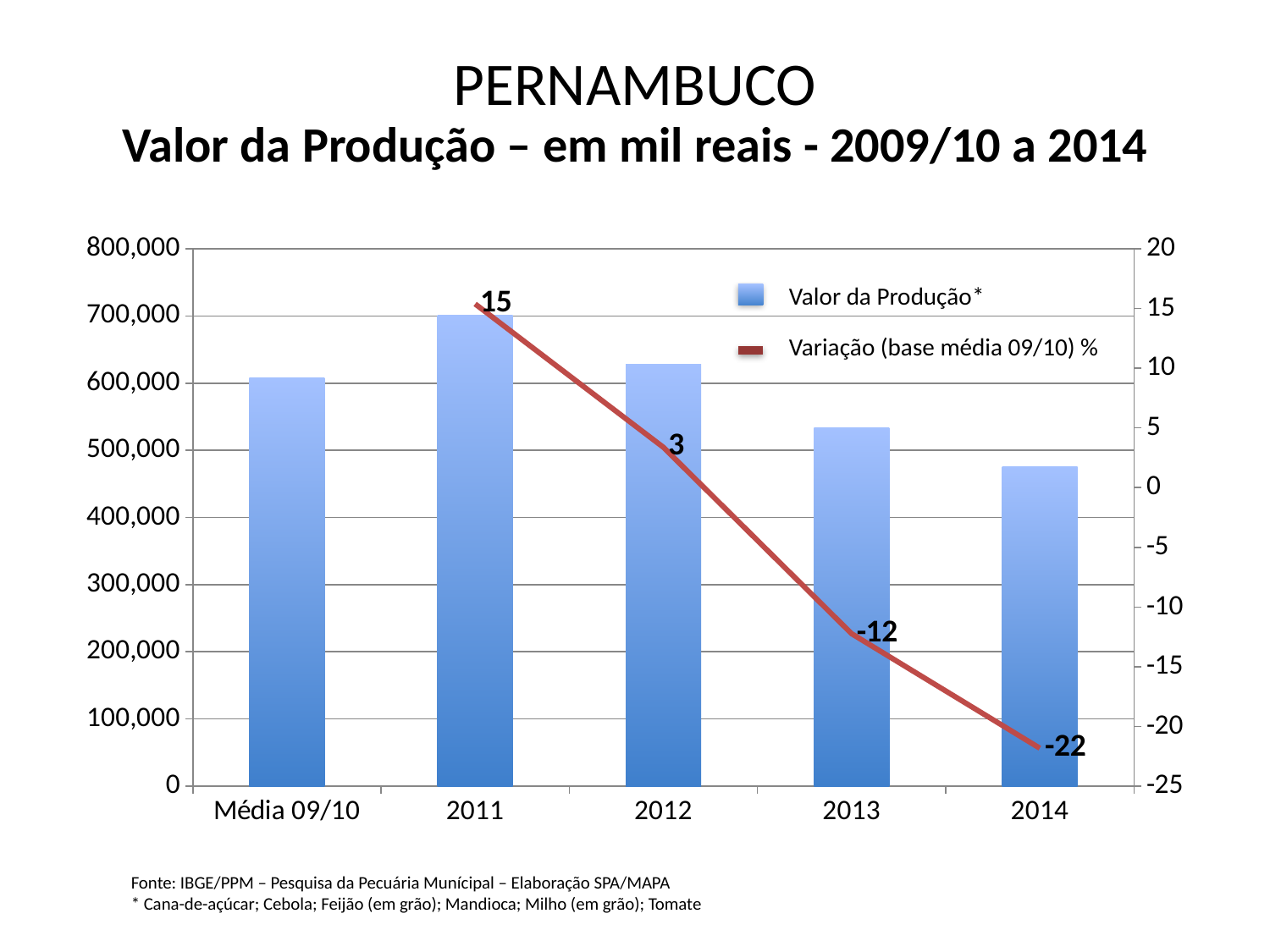
What is the Variação (base média 09/10) % value for 2014? -22 Is the Valor da Produção bar for 2014 greater or less than 500,000? less Which has a larger Valor da Produção bar, 2012 or 2013? 2012 Is the Valor da Produção bar for 2011 greater or less than 600,000? greater How many categories are shown on the x axis? 5 What is the Variação (base média 09/10) % value for 2011? 15 What is the difference between the Variação values for 2011 and 2014? 37 Which year has the lowest Valor da Produção bar? 2014 Does the Variação line rise or fall from 2011 to 2014? fall What is the Variação (base média 09/10) % value for 2013? -12 How many series does the legend list? 2 Which year has the highest Valor da Produção bar? 2011